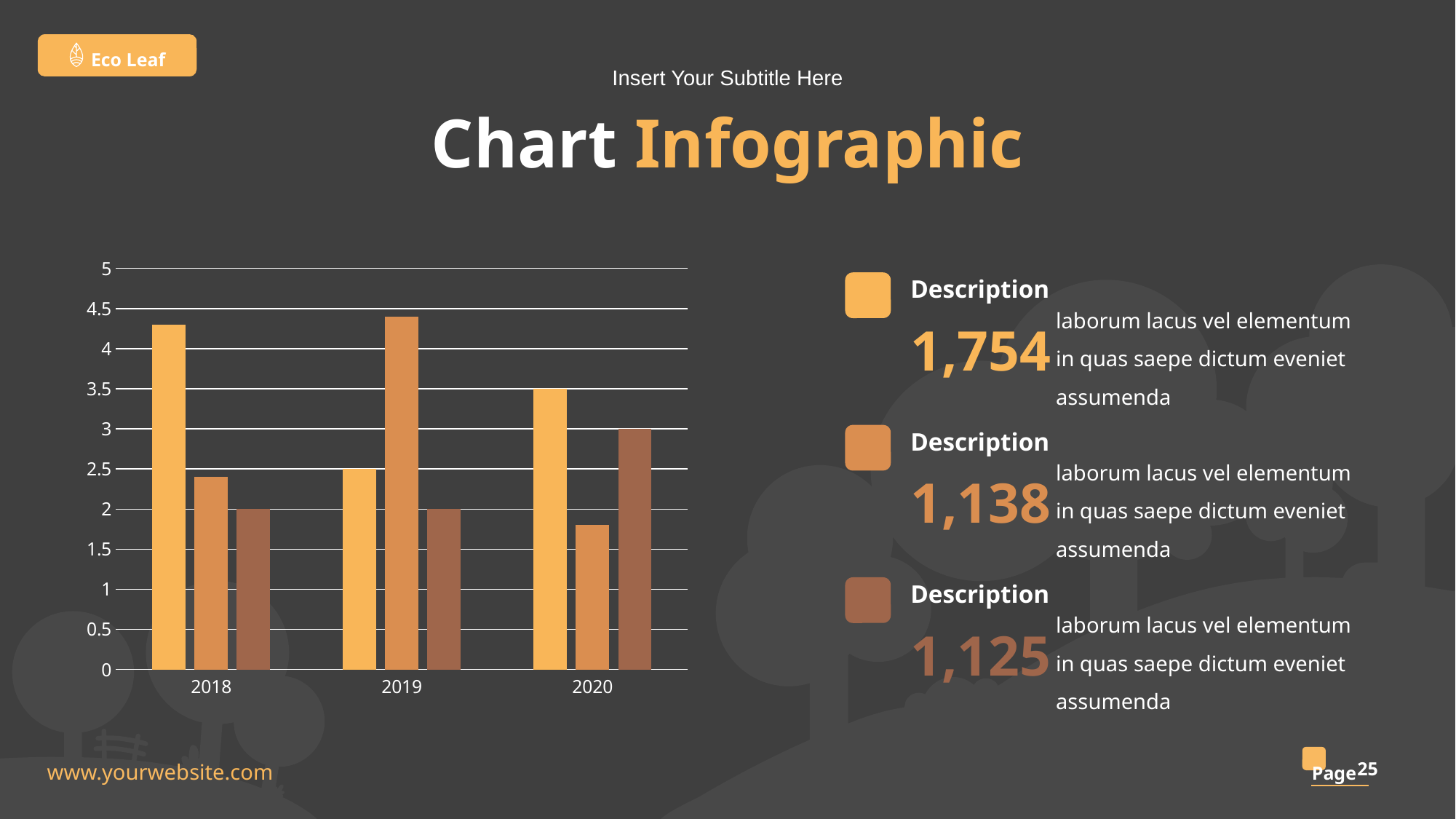
What is the value of the yellow bar for 2019? 2.5 Which coloured bar is the lowest in 2020? orange What is the value of the brown bar for 2020? 3 By how much does the brown bar for 2020 exceed the brown bar for 2018? 1 What kind of chart is shown on the slide? bar chart What is the value of the yellow bar for 2020? 3.5 What is the value of the brown bar for 2018? 2 Is the value of the orange bar for 2020 greater or less than 2? less Which is larger, the yellow bar for 2020 or the brown bar for 2020? yellow bar for 2020 How many years are shown on the x axis of the chart? 3 Is the value of the yellow bar for 2018 greater or less than 4? greater Which coloured bar is the highest in 2019? orange